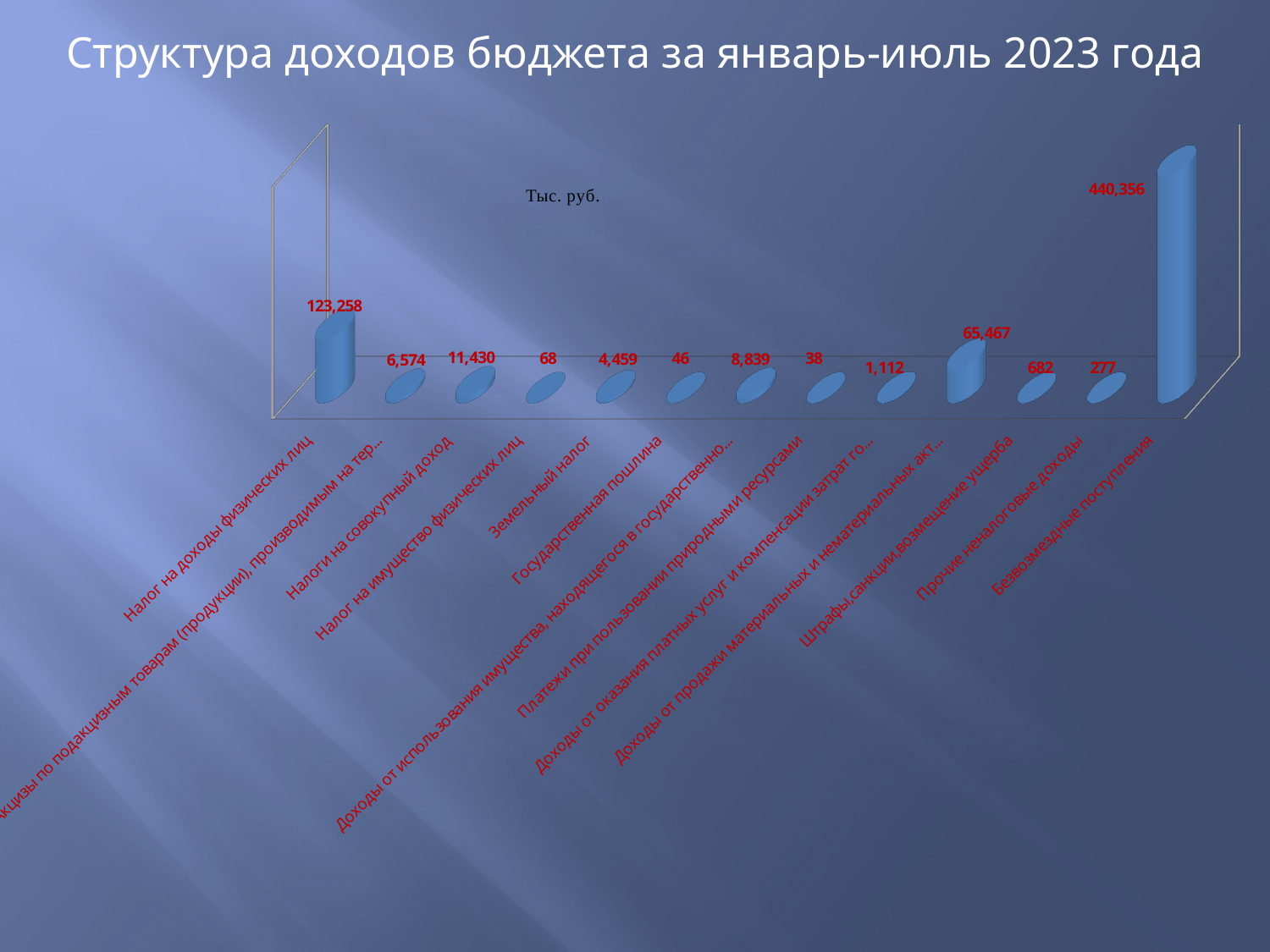
What kind of chart is shown on the slide? Bar chart How many categories are shown in the chart? 13 What is the value for Штрафы, санкции, возмещение ущерба? 682 What is the value for Безвозмездные поступления? 440,356 What is the value for Налог на доходы физических лиц? 123,258 What unit is indicated on the chart? Тыс. руб. What is the difference between the values for Налоги на совокупный доход and the Акцизы category? 4,856 Which category has the lowest value? Платежи при пользовании природными ресурсами What is the difference between the values for Безвозмездные поступления and Налог на доходы физических лиц? 317,098 What is the value for Земельный налог? 4,459 Which category has the highest value? Безвозмездные поступления Which is larger: the value for Государственная пошлина or the value for Налог на имущество физических лиц? Налог на имущество физических лиц